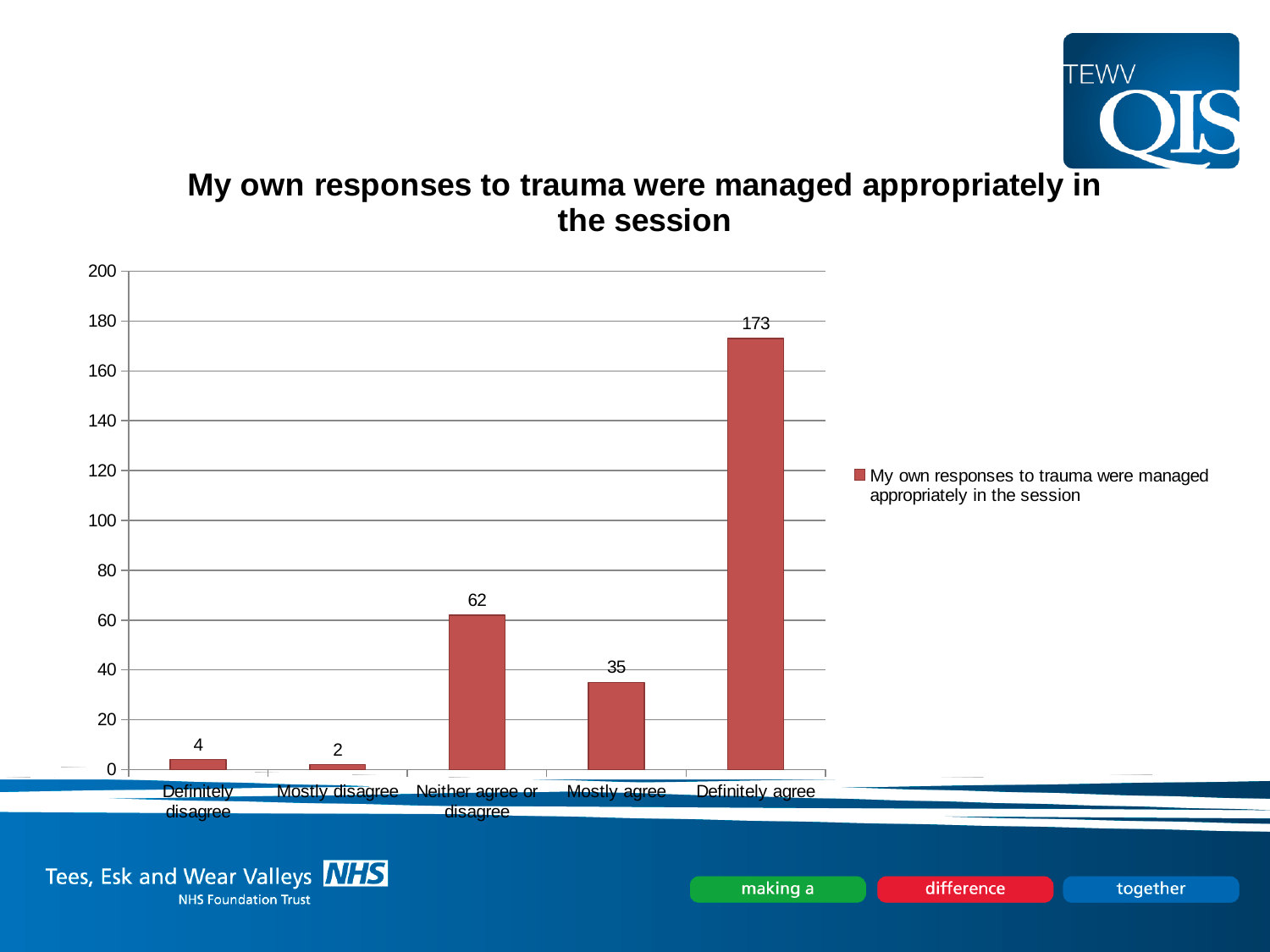
What is the value for Definitely agree? 173 What is the title of the chart? My own responses to trauma were managed appropriately in the session Which category has the lowest value? Mostly disagree Which category has the highest value? Definitely agree What is the value for Neither agree or disagree? 62 What is the difference between the values for Definitely agree and Mostly agree? 138 What is the value for Mostly disagree? 2 How many categories are shown on the x axis? 5 Is the value for Definitely agree greater or less than 160? greater What is the value for Mostly agree? 35 Which is larger, the value for Neither agree or disagree or the value for Mostly agree? Neither agree or disagree What kind of chart is shown on the slide? Bar chart